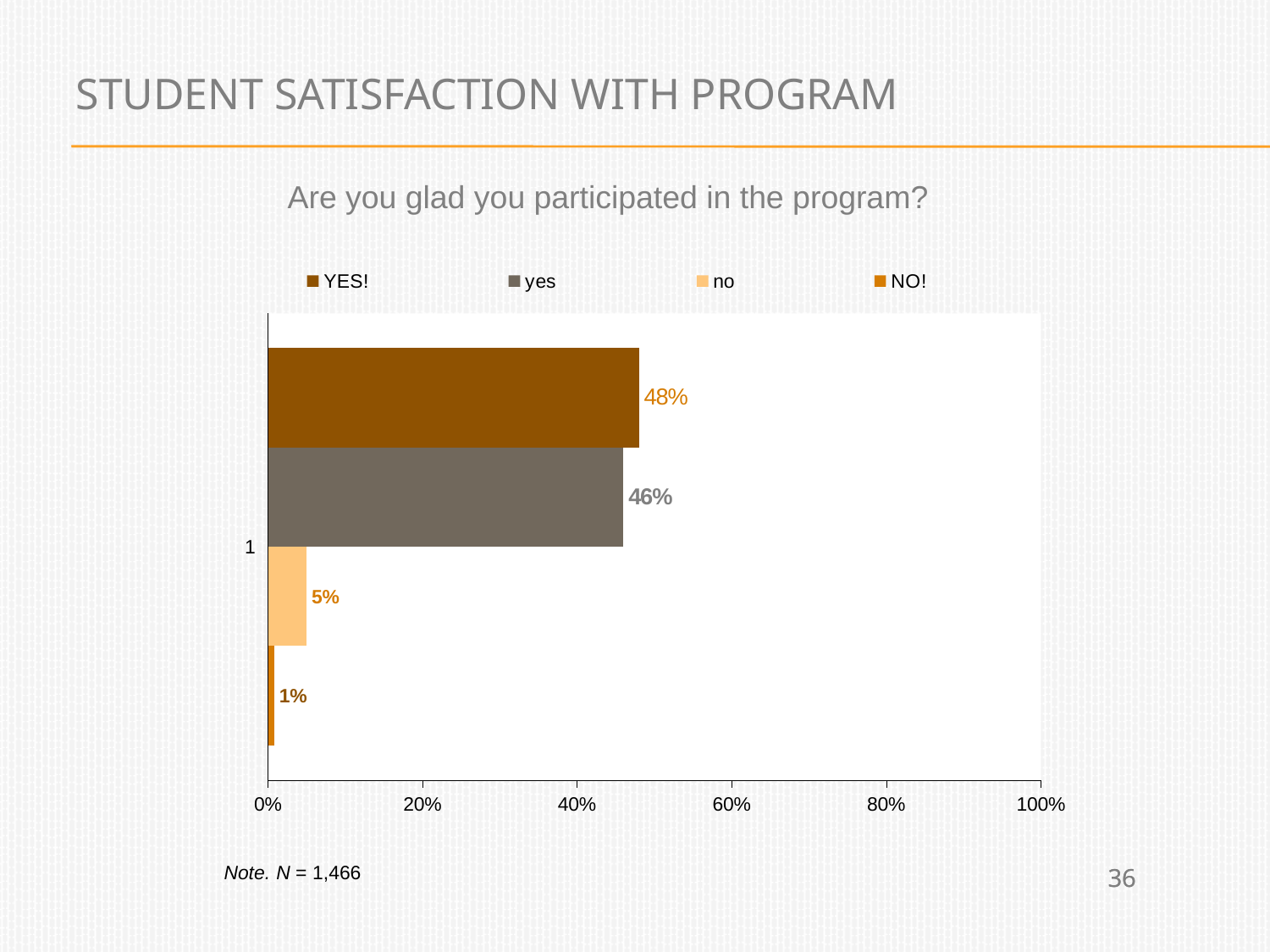
How many series does the legend list? 4 What percentage of students answered "yes"? 46% Which response has the highest percentage? YES! Which response has the lowest percentage? NO! What percentage of students answered "YES!" to "Are you glad you participated in the program?" 48% Which response is larger, "no" or "NO!"? no What kind of chart is shown on the slide? Bar chart What is the difference in percentage points between the "no" and "NO!" responses? 4% What is the question shown as the chart title? Are you glad you participated in the program? What is the difference in percentage points between the "YES!" and "yes" responses? 2% What percentage of students answered "no"? 5% What percentage of students answered "NO!"? 1%